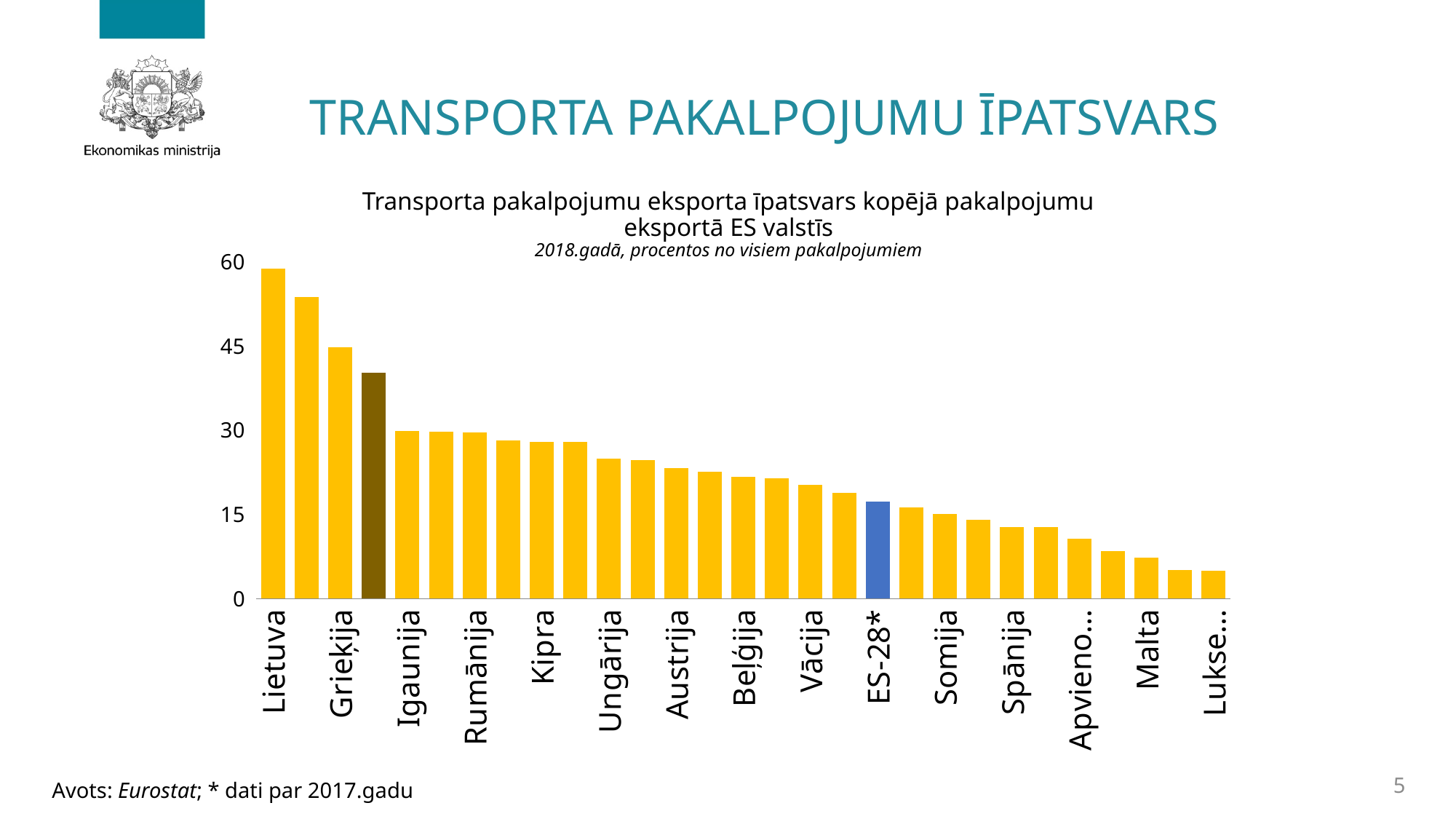
What colour is the bar for ES-28*? blue Is the value for Ungārija greater or less than 15? greater Is the value for Lietuva greater or less than 45? greater Is the value for Spānija greater or less than 15? less What kind of chart is shown on the slide? bar chart Which country has the highest share of transport services in total services exports? Lietuva Which is larger, the value for Lietuva or the value for Grieķija? Lietuva What year does the chart subtitle say the data refer to? 2018 Which is larger, the value for Kipra or the value for Vācija? Kipra Do the bar values rise or fall from left to right along the x axis? fall